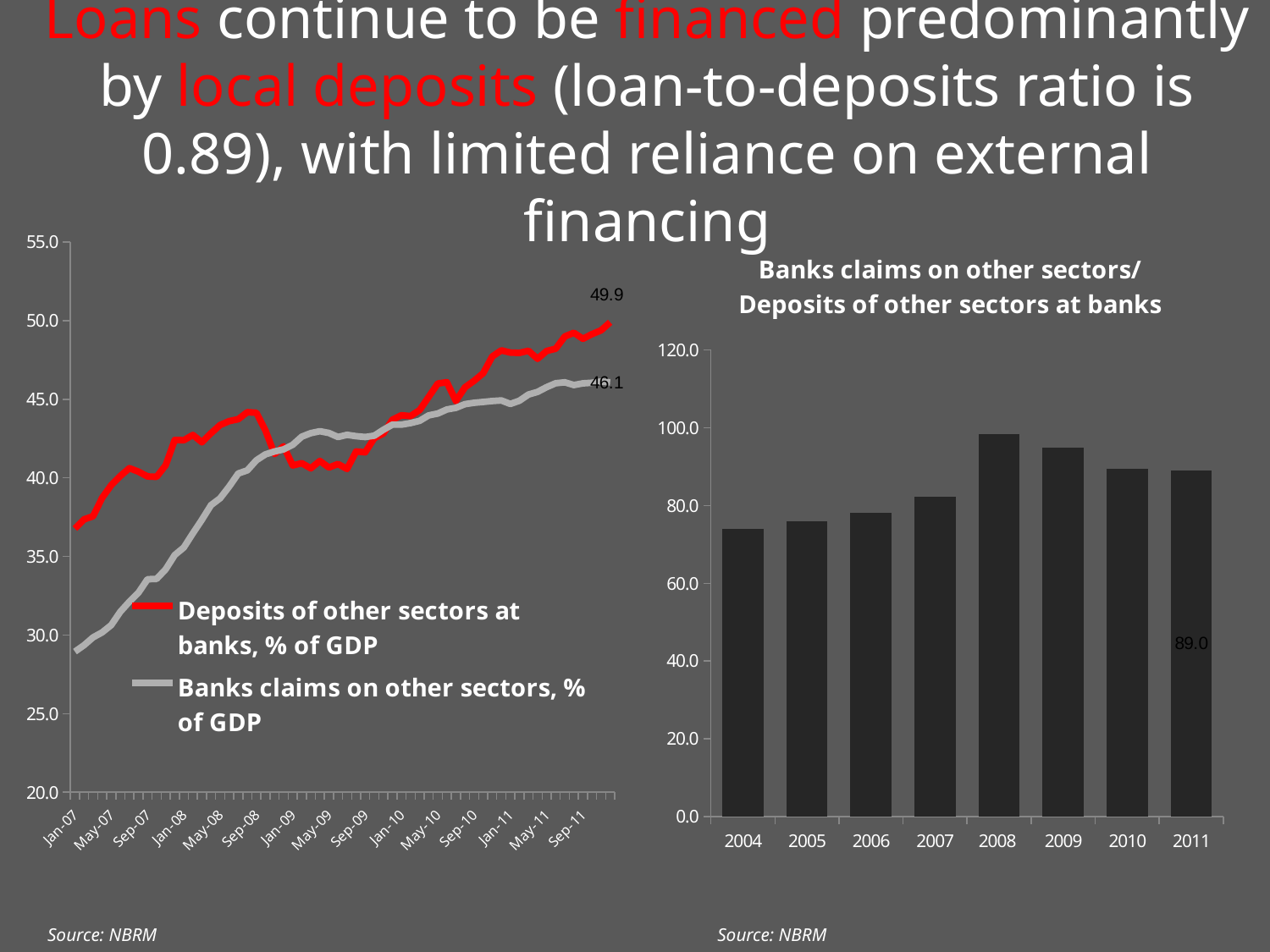
In the 'Banks claims on other sectors/ Deposits of other sectors at banks' chart, which year has the lowest value? 2004 What kind of chart is the chart on the left of the slide? line chart On the left line chart, what is the final labelled value of the 'Deposits of other sectors at banks, % of GDP' series? 49.9 In the 'Banks claims on other sectors/ Deposits of other sectors at banks' chart, which year has the highest value? 2008 On the left line chart, how many series does the legend list? 2 In the 'Banks claims on other sectors/ Deposits of other sectors at banks' chart, is the value for 2004 greater or less than 80.0? less On the left line chart, what is the difference between the two final labelled values, 49.9 and 46.1? 3.8 On the left line chart, do the values of the 'Banks claims on other sectors, % of GDP' series generally rise or fall from Jan-07 to Sep-11? rise On the left line chart, what is the final labelled value of the 'Banks claims on other sectors, % of GDP' series? 46.1 In the 'Banks claims on other sectors/ Deposits of other sectors at banks' chart, what is the value for 2011? 89.0 In the 'Banks claims on other sectors/ Deposits of other sectors at banks' chart, how many years are shown on the x axis? 8 On the left line chart, which series is drawn in red? Deposits of other sectors at banks, % of GDP